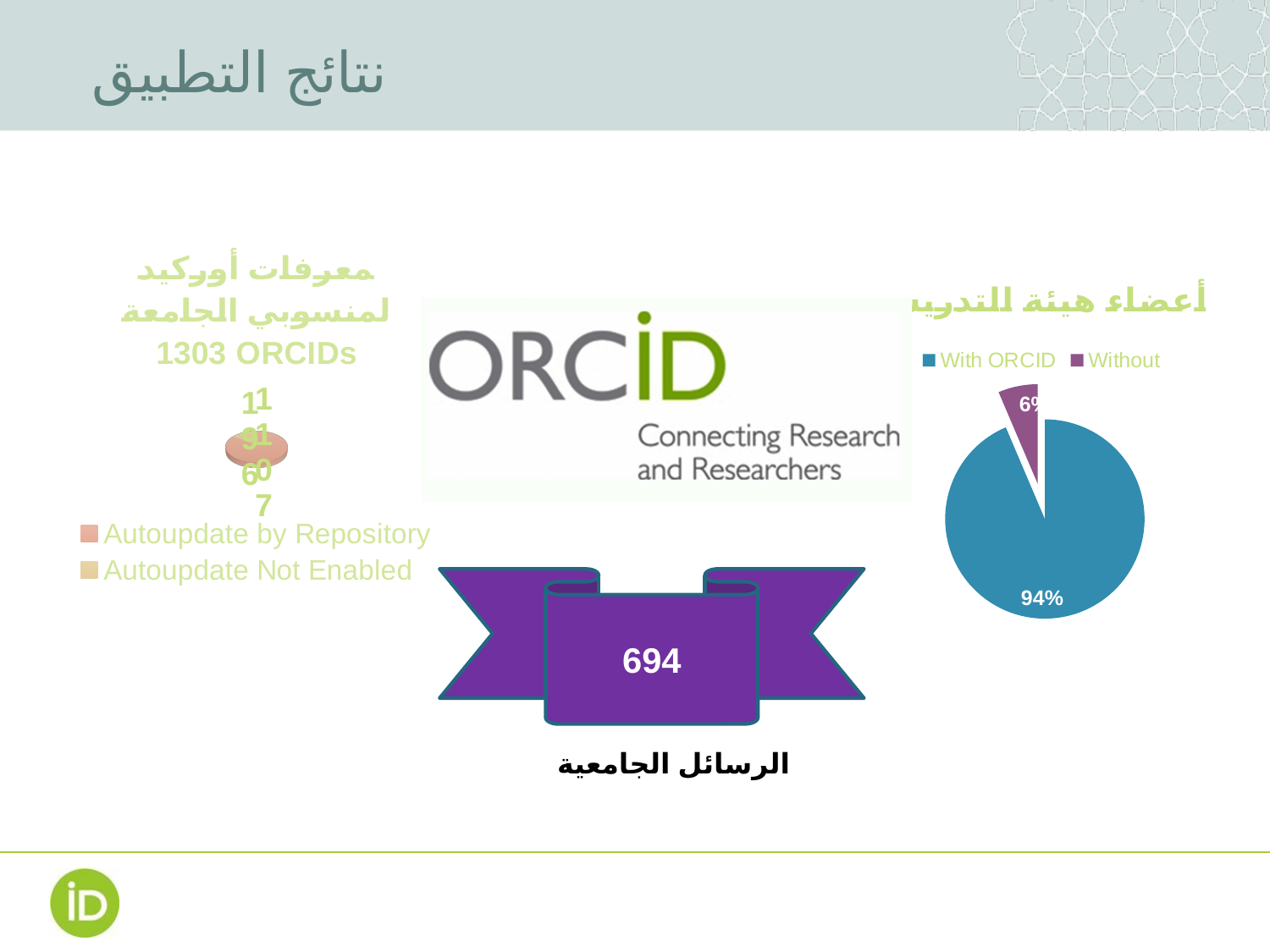
What kind of chart is shown on the right of the slide? Pie chart On the pie chart on the right of the slide, what share is labelled for Without? 6% On the pie chart on the right of the slide, what colour is the With ORCID slice? Blue On the pie chart on the right of the slide, what share is labelled for With ORCID? 94% On the pie chart on the right of the slide, which category has the smallest slice? Without What kind of chart is shown on the left of the slide under the heading 1303 ORCIDs? Pie chart On the pie chart on the right of the slide, how many entries does the legend list? 2 On the pie chart on the right of the slide, which category has the largest slice? With ORCID On the pie chart on the right of the slide, which is larger: With ORCID or Without? With ORCID On the pie chart on the right of the slide, by how many percentage points does With ORCID exceed Without? 88 percentage points On the chart on the left of the slide, what is the first legend entry shown? Autoupdate by Repository On the pie chart on the right of the slide, how many slices does the pie have? 2